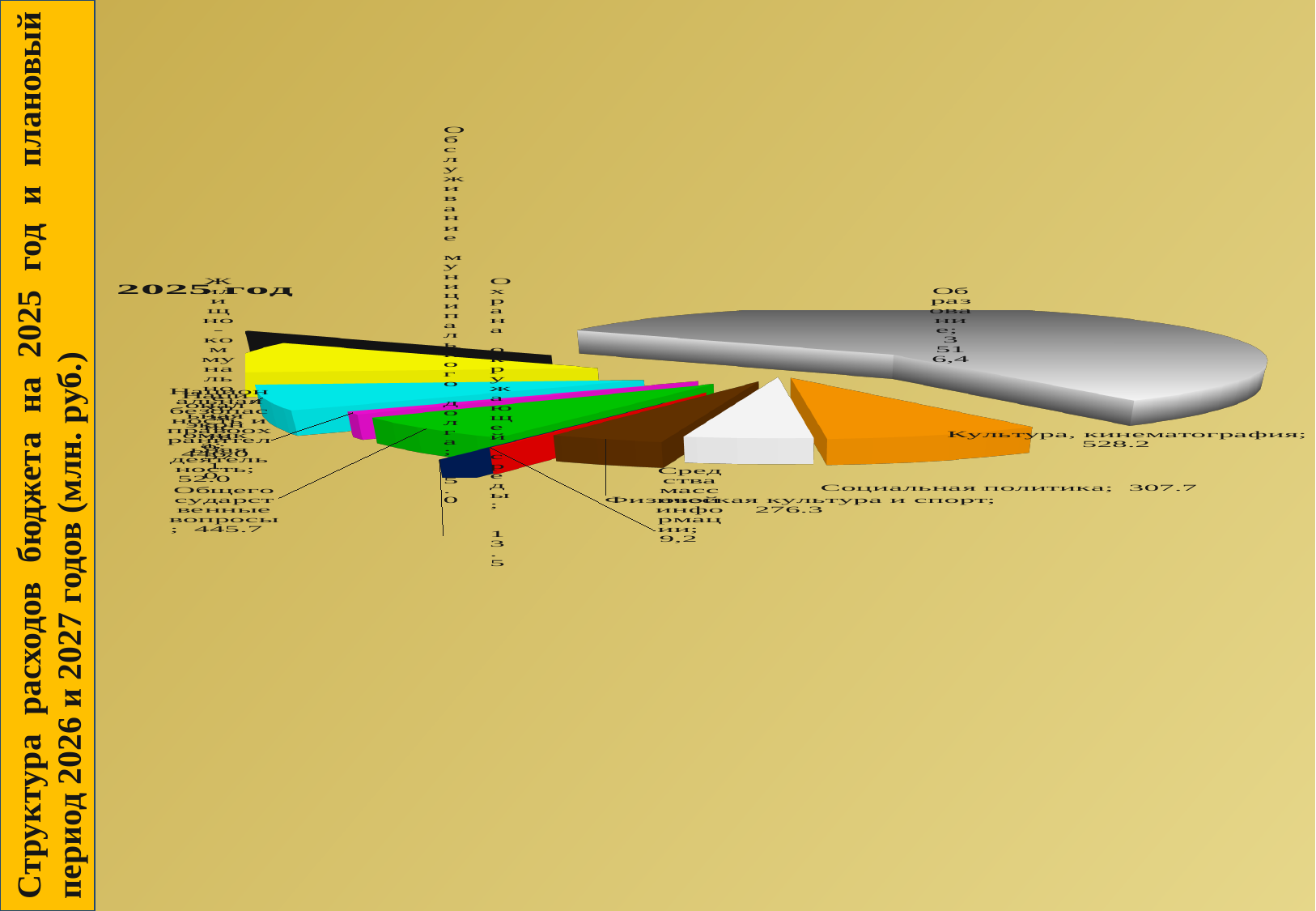
What is the value for Культура, кинематография in the pie chart? 528.2 What is the value for Общегосударственные вопросы in the pie chart? 445.7 Which category has the largest slice in the pie chart? Образование What is the value for Социальная политика in the pie chart? 307.7 What is the value for Физическая культура и спорт in the pie chart? 276.3 What colour is the largest slice (Образование) in the pie chart? grey What is the difference between the values for Культура, кинематография and Социальная политика? 220.5 Which is larger in the pie chart: Культура, кинематография or Социальная политика? Культура, кинематография What is the difference between the values for Общегосударственные вопросы and Физическая культура и спорт? 169.4 What is the value for Средства массовой информации in the pie chart? 9,2 What kind of chart is shown on the slide? pie chart Which year is the pie chart labelled with? 2025 год